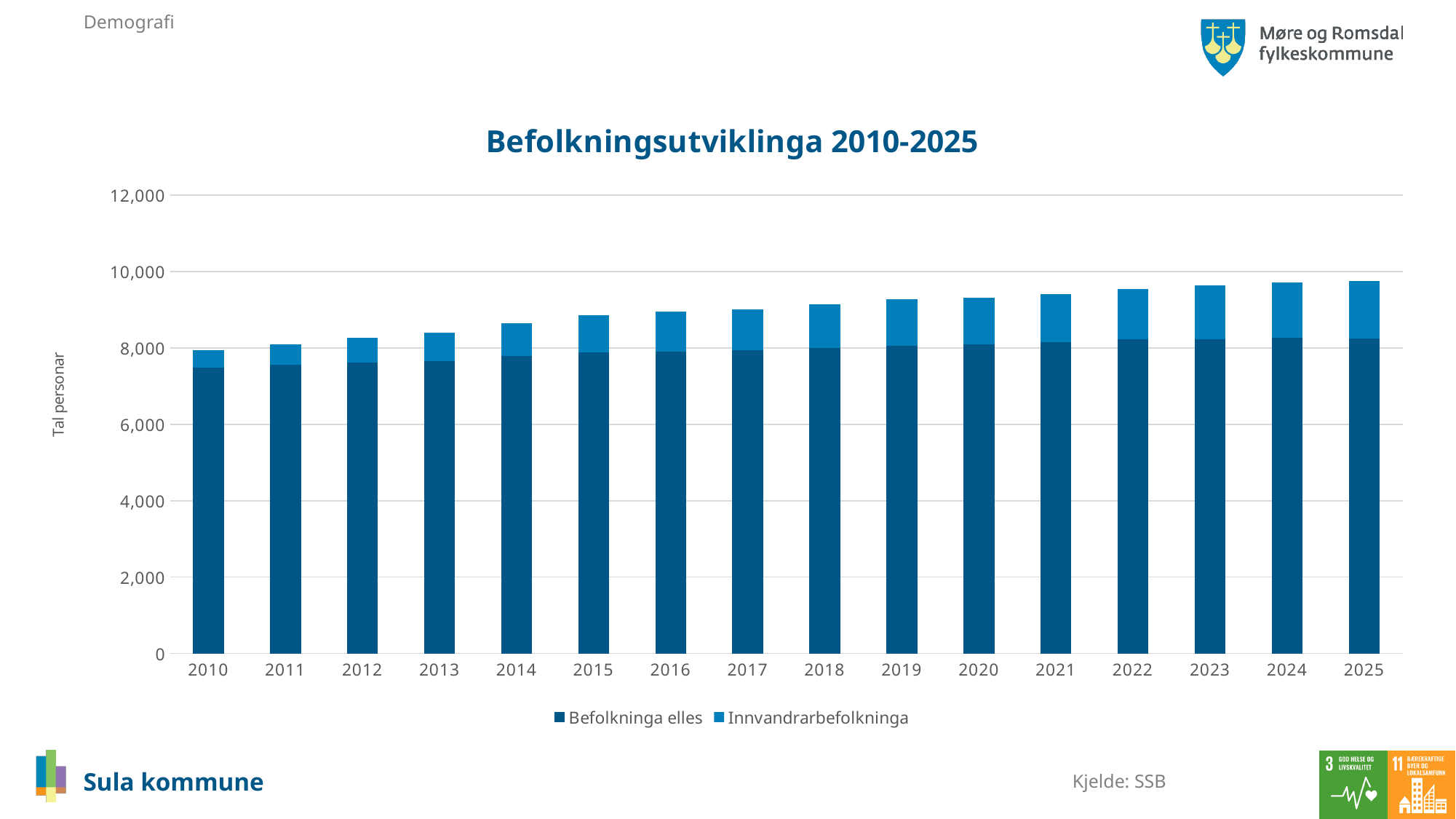
How many series does the legend list? 2 What kind of chart is shown on the slide? stacked bar chart Do the total bar heights rise or fall from 2010 to 2025? rise Which year has the larger total bar, 2010 or 2020? 2020 How many years are shown along the x axis? 16 Is the total bar height for 2025 greater or less than 10,000? less What is the title of the chart? Befolkningsutviklinga 2010-2025 Is the value of Befolkninga elles for 2010 greater or less than 8,000? less Which series is shown in the darker blue colour? Befolkninga elles Is the total bar height for 2015 greater or less than 8,000? greater